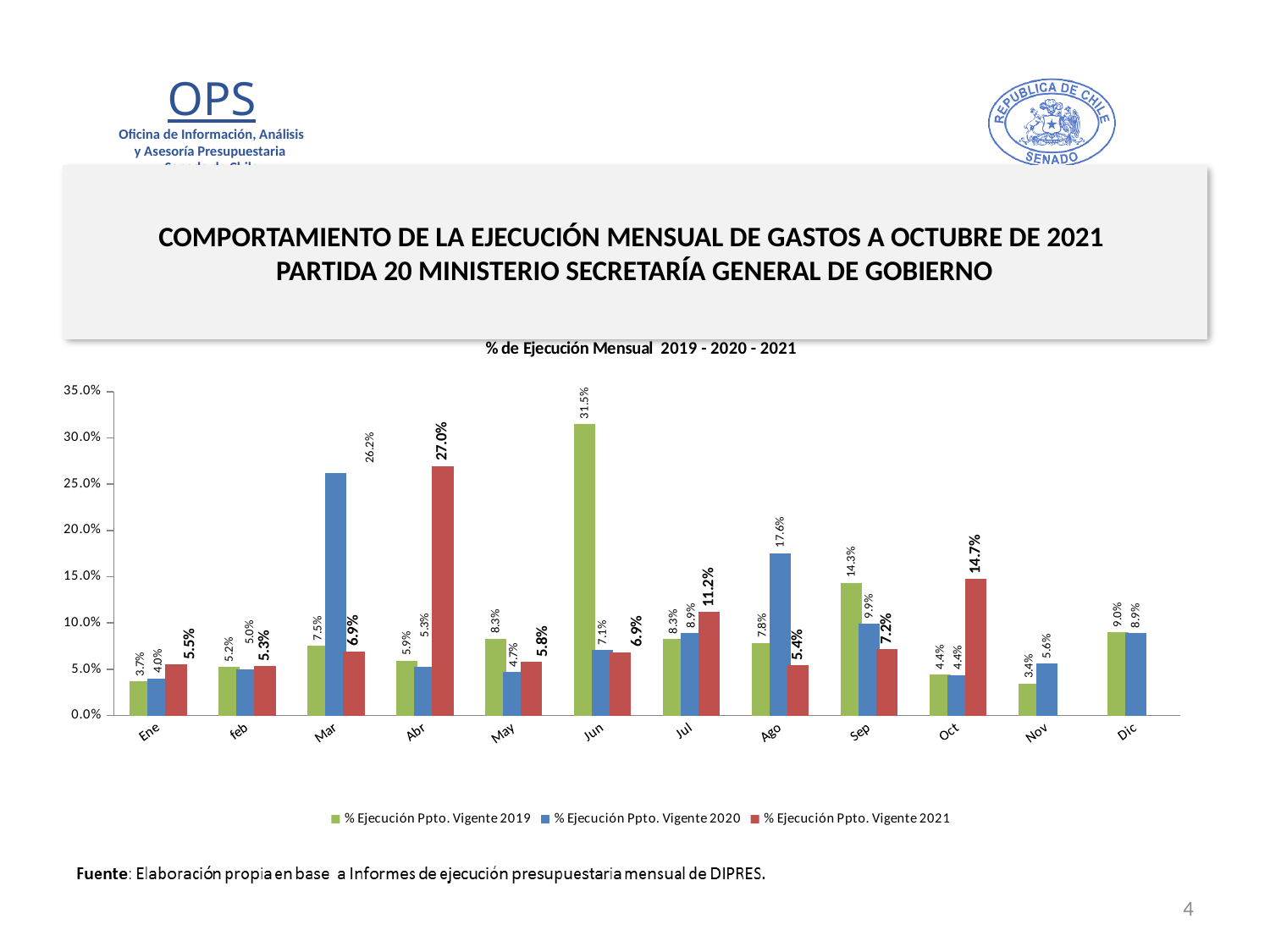
What is the difference between the 2020 and 2019 values in Ago? 9.8% How many months are shown on the x axis? 12 In which month is the % Ejecución Ppto. Vigente 2019 series highest? Jun What kind of chart is shown on the slide? Bar chart How many series does the legend list? 3 Which is larger in Oct: the 2021 value or the 2019 value? 2021 value In which month is the % Ejecución Ppto. Vigente 2021 series lowest? Feb What is the value for % Ejecución Ppto. Vigente 2021 in Abr? 27.0% Is the value for % Ejecución Ppto. Vigente 2019 in Jun greater or less than 30.0%? greater What is the value for % Ejecución Ppto. Vigente 2019 in Sep? 14.3% What is the title of the chart? % de Ejecución Mensual 2019 - 2020 - 2021 What is the value for % Ejecución Ppto. Vigente 2020 in Mar? 26.2%